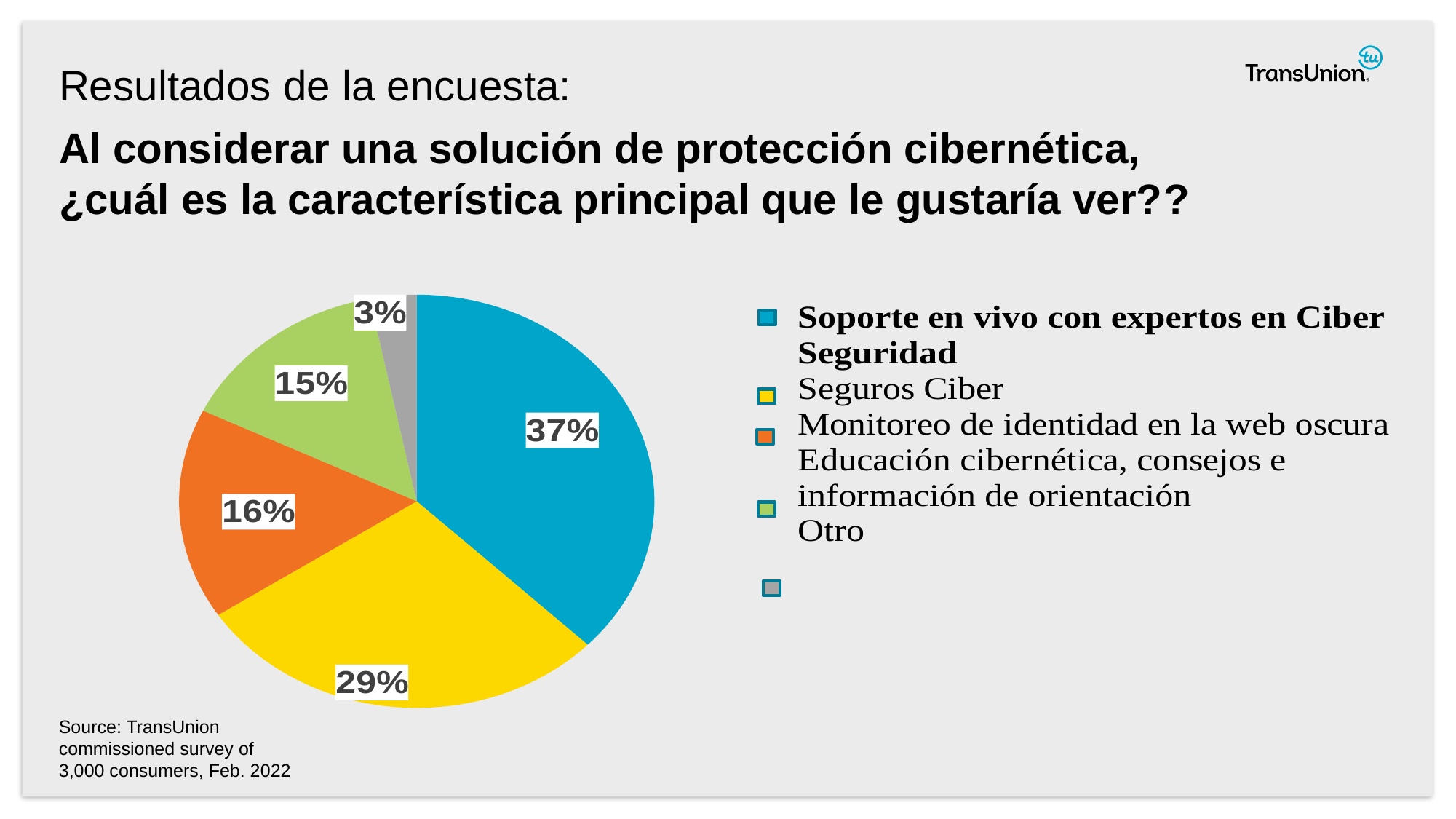
What kind of chart is shown on the slide? Pie chart What share of the pie does "Soporte en vivo con expertos en Ciber Seguridad" represent? 37% What percentage is shown for "Otro"? 3% Which is larger, the slice for "Monitoreo de identidad en la web oscura" or the slice for "Otro"? Monitoreo de identidad en la web oscura Which category has the smallest slice of the pie? Otro How many slices does the pie chart have? 5 What percentage is shown for "Monitoreo de identidad en la web oscura"? 16% What percentage is shown for "Educación cibernética, consejos e información de orientación"? 15% What colour is the slice for "Seguros Ciber"? Yellow Which category has the largest slice of the pie? Soporte en vivo con expertos en Ciber Seguridad What percentage is shown for "Seguros Ciber"? 29% What is the difference in percentage points between "Soporte en vivo con expertos en Ciber Seguridad" and "Seguros Ciber"? 8